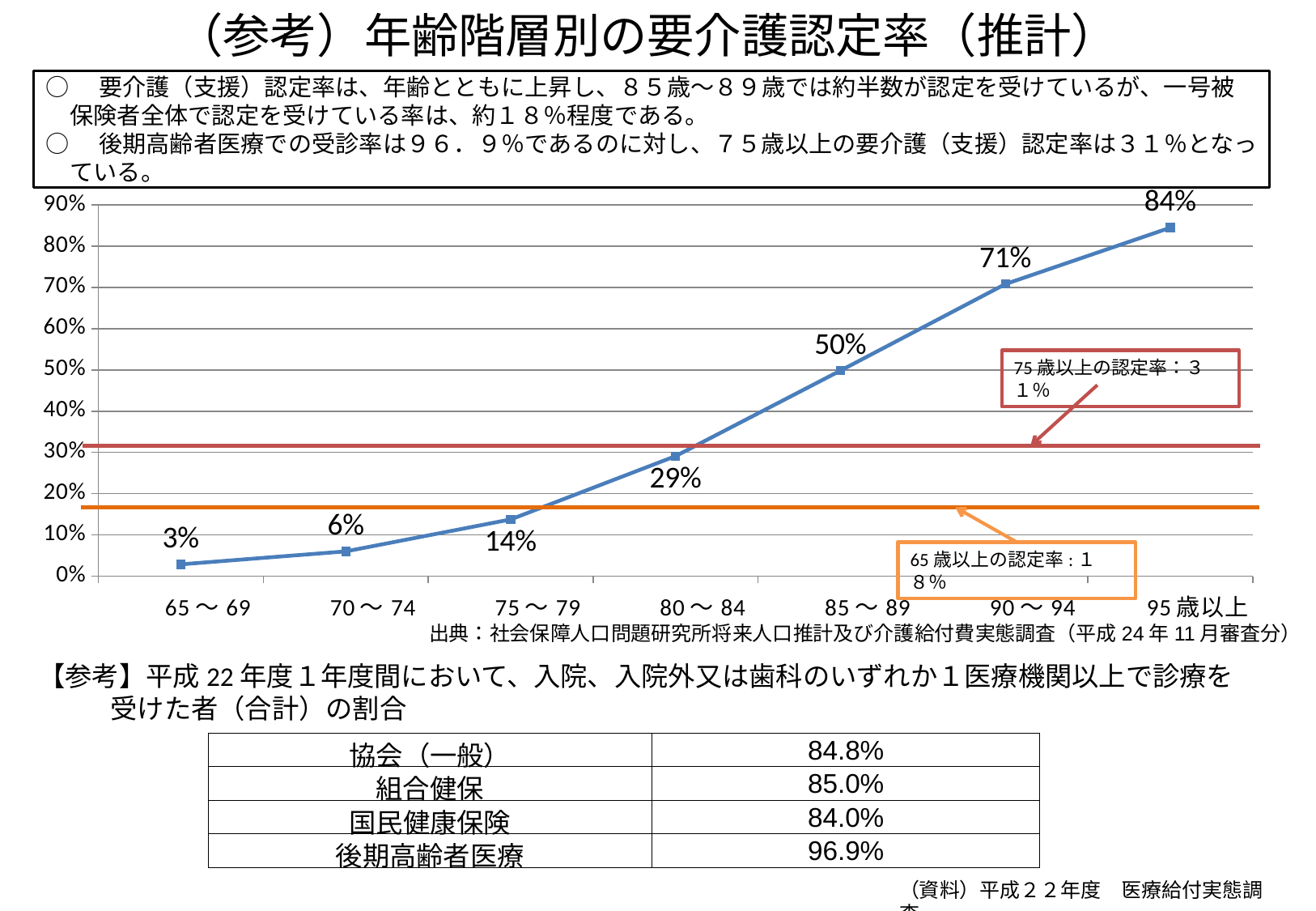
Do the certification rates rise or fall as age increases along the x axis? Rise What is the certification rate for the 65～69 age group? 3% Which age group has the lowest certification rate? 65～69 What is the certification rate for the 85～89 age group? 50% Which is larger, the certification rate for 75～79 or for 70～74? 75～79 What is the certification rate for the 95歳以上 age group? 84% How many age groups are plotted on the x axis? 7 What kind of chart is shown on the slide? Line chart What certification rate does the red horizontal reference line represent, according to its label? 31% (75歳以上の認定率) Which age group has the highest certification rate? 95歳以上 What certification rate does the orange horizontal reference line represent, according to its label? 18% (65歳以上の認定率) What is the difference between the certification rates for 90～94 and 80～84? 42%